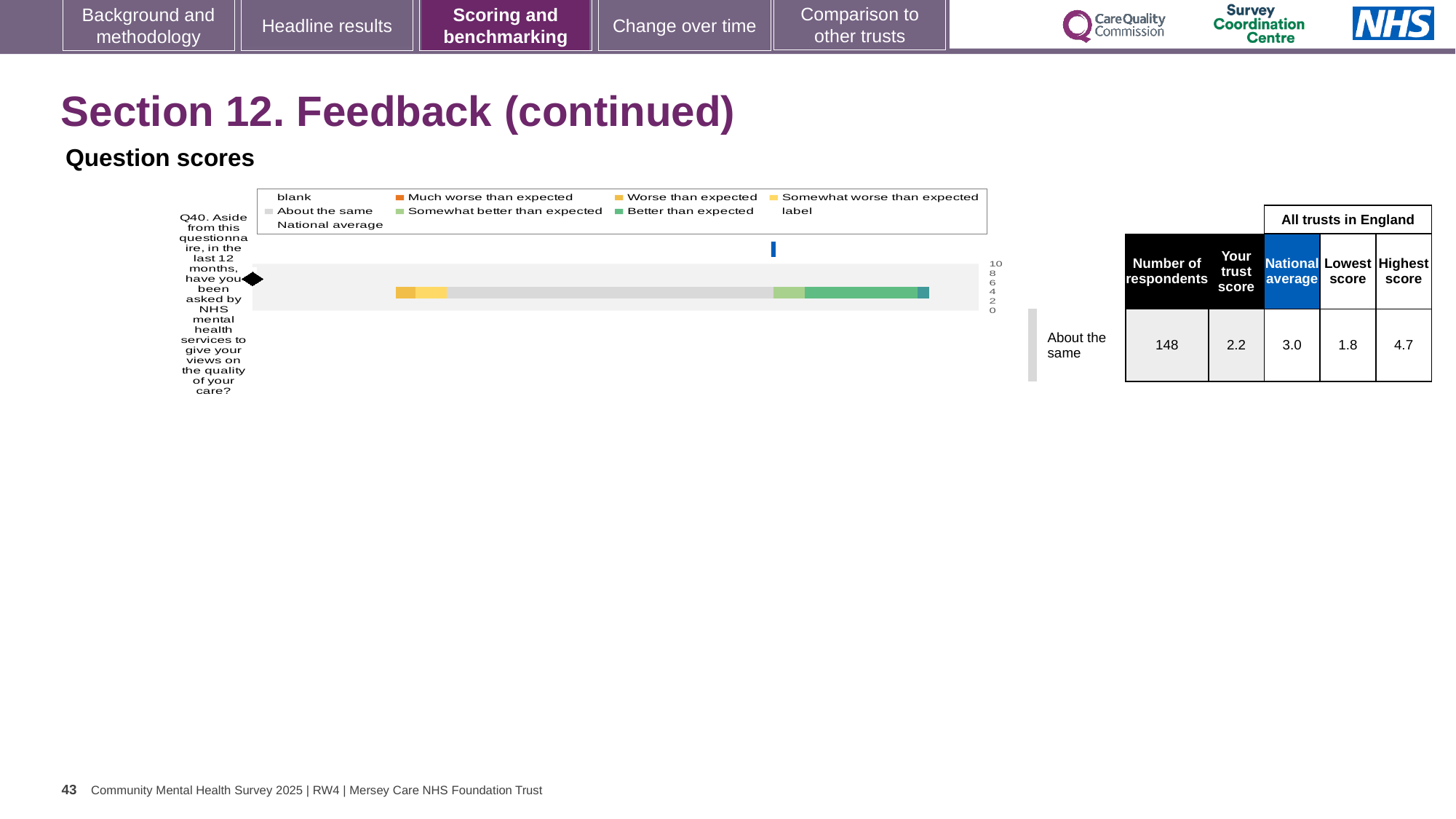
What is the trust score for Q40 shown in the table beside the chart? 2.2 How many questions (categories) are plotted on the chart? 1 What is the national average for Q40 shown in the table beside the chart? 3.0 What is the lowest score among all trusts in England for Q40? 1.8 What kind of chart is shown on the slide? bar chart For Q40, what is the difference between the highest score and the lowest score among all trusts in England? 2.9 Which question number is plotted on the chart? Q40 For Q40, which is larger: the trust score or the national average? National average How many entries does the chart legend list? 9 How many respondents answered Q40 according to the table beside the chart? 148 What is the highest score among all trusts in England for Q40? 4.7 What benchmark category is shown for Q40 next to the chart? About the same